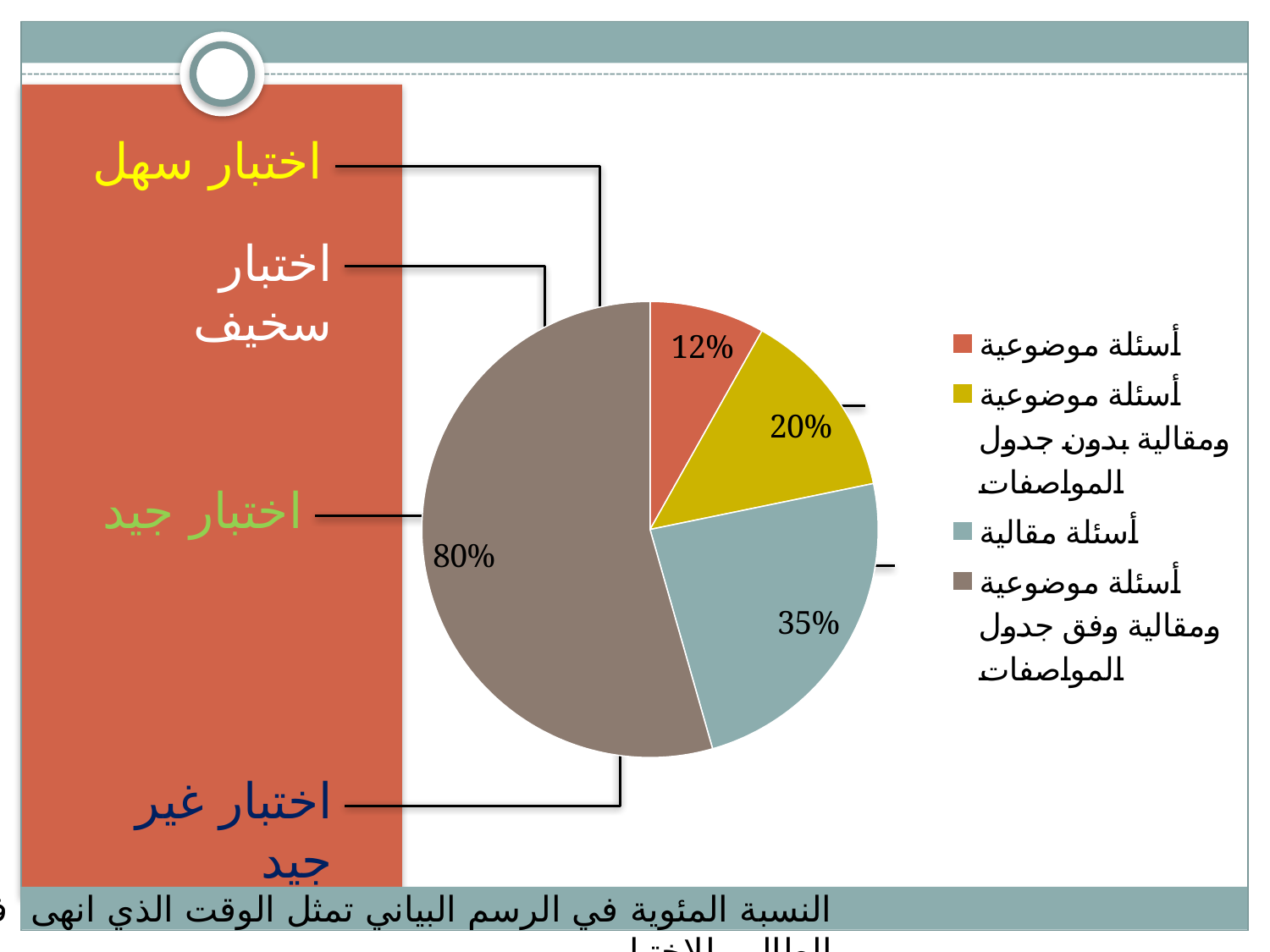
What value is labelled on the slice for أسئلة مقالية? 35% What value is labelled on the slice for أسئلة موضوعية? 12% What colour is the slice for أسئلة مقالية in the pie chart? teal (blue-grey) Which legend category has the largest slice in the pie chart? أسئلة موضوعية ومقالية وفق جدول المواصفات What value is labelled on the slice for أسئلة موضوعية ومقالية بدون جدول المواصفات? 20% How many slices does the pie chart have? 4 What value is labelled on the slice for أسئلة موضوعية ومقالية وفق جدول المواصفات? 80% Which legend category has the smallest slice in the pie chart? أسئلة موضوعية Which has the larger labelled value: أسئلة مقالية or أسئلة موضوعية ومقالية بدون جدول المواصفات? أسئلة مقالية What is the difference between the labelled values for أسئلة موضوعية ومقالية وفق جدول المواصفات and أسئلة مقالية? 45% How many entries does the legend of the pie chart list? 4 What type of chart is shown on the slide? pie chart